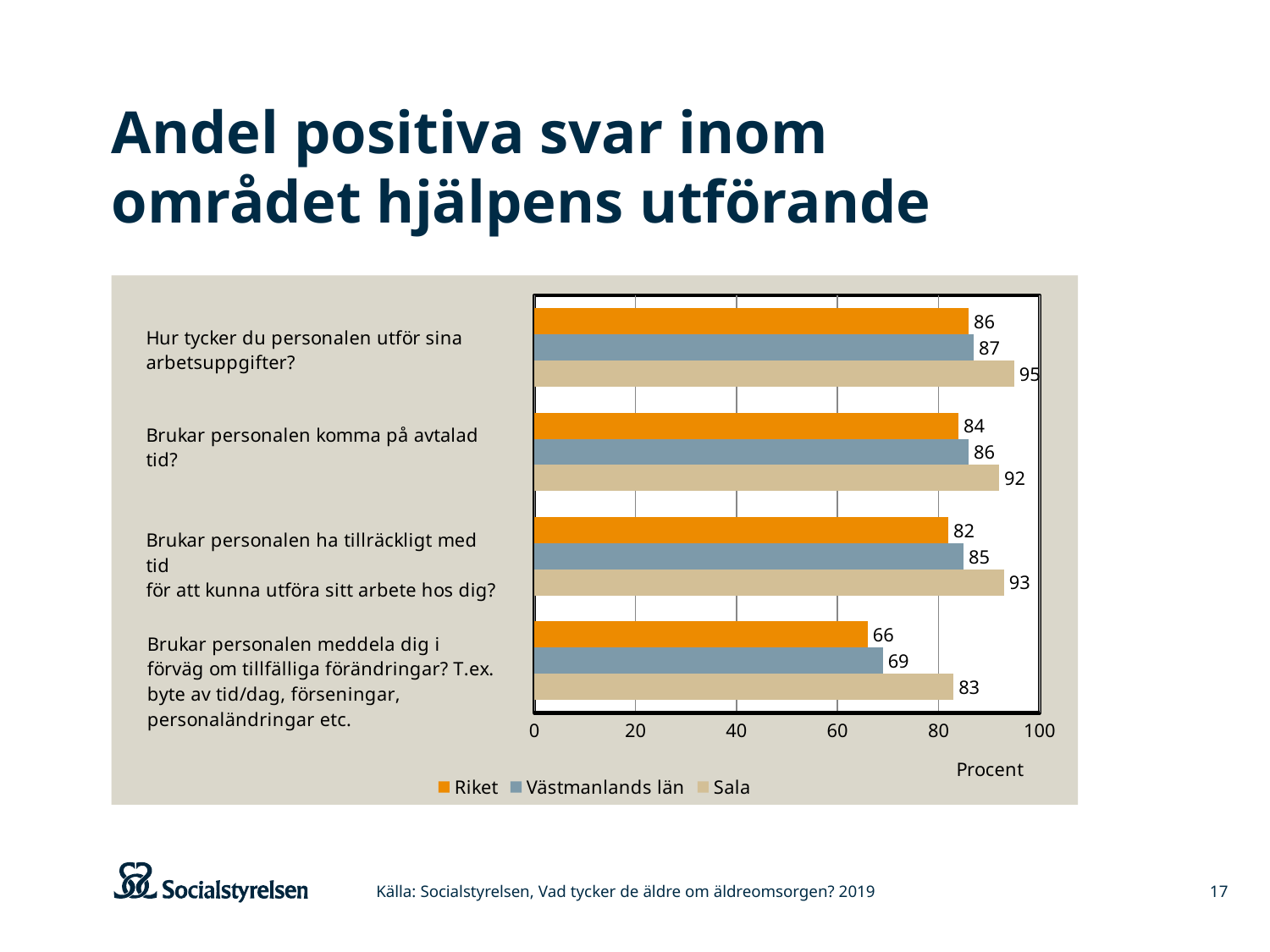
Which is larger on "Brukar personalen komma på avtalad tid?": Riket or Sala? Sala How many questions (categories) are shown in the chart? 4 What is the difference between Sala and Riket on "Brukar personalen meddela dig i förväg om tillfälliga förändringar?"? 17 Is the value for Västmanlands län on "Brukar personalen meddela dig i förväg om tillfälliga förändringar?" greater or less than 80? less Which question has the lowest value for Sala? Brukar personalen meddela dig i förväg om tillfälliga förändringar? Which question has the highest value for Riket? Hur tycker du personalen utför sina arbetsuppgifter? How many series does the legend list? 3 What kind of chart is shown on the slide? Bar chart What is the value for Sala on "Hur tycker du personalen utför sina arbetsuppgifter?"? 95 What is the value for Västmanlands län on "Brukar personalen komma på avtalad tid?"? 86 What is the value for Riket on "Brukar personalen meddela dig i förväg om tillfälliga förändringar?"? 66 What is the difference between Sala and Västmanlands län on "Brukar personalen ha tillräckligt med tid för att kunna utföra sitt arbete hos dig?"? 8